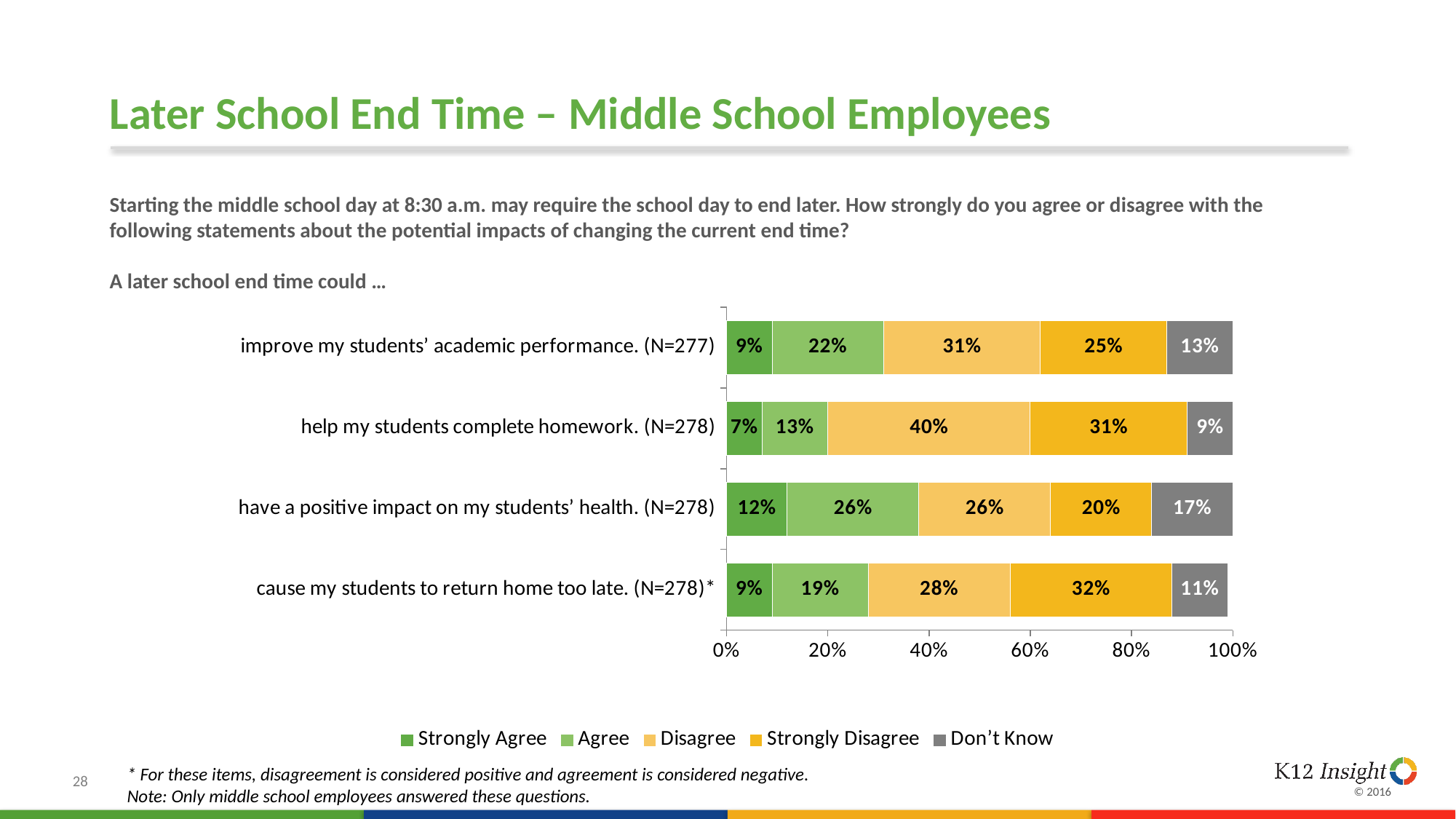
How many series does the legend list? 5 What kind of chart is shown on the slide? Stacked bar chart Which statement has the highest Strongly Agree percentage? have a positive impact on my students' health. (N=278) Which statement has the lowest Agree percentage? help my students complete homework. (N=278) How many statements are shown in the chart? 4 What is the difference between the Disagree percentage for 'help my students complete homework' and the Disagree percentage for 'improve my students' academic performance'? 9% What percentage of respondents disagree that a later school end time could help their students complete homework? 40% What percentage of respondents answered Don't Know for 'have a positive impact on my students' health'? 17% What percentage of middle school employees strongly agree that a later school end time could improve their students' academic performance? 9% Which is larger: the Strongly Disagree percentage for 'help my students complete homework' or for 'have a positive impact on my students' health'? help my students complete homework. (N=278) What is the combined percentage of Strongly Agree and Agree for 'cause my students to return home too late'? 28% What percentage of respondents strongly disagree that a later school end time could cause their students to return home too late? 32%